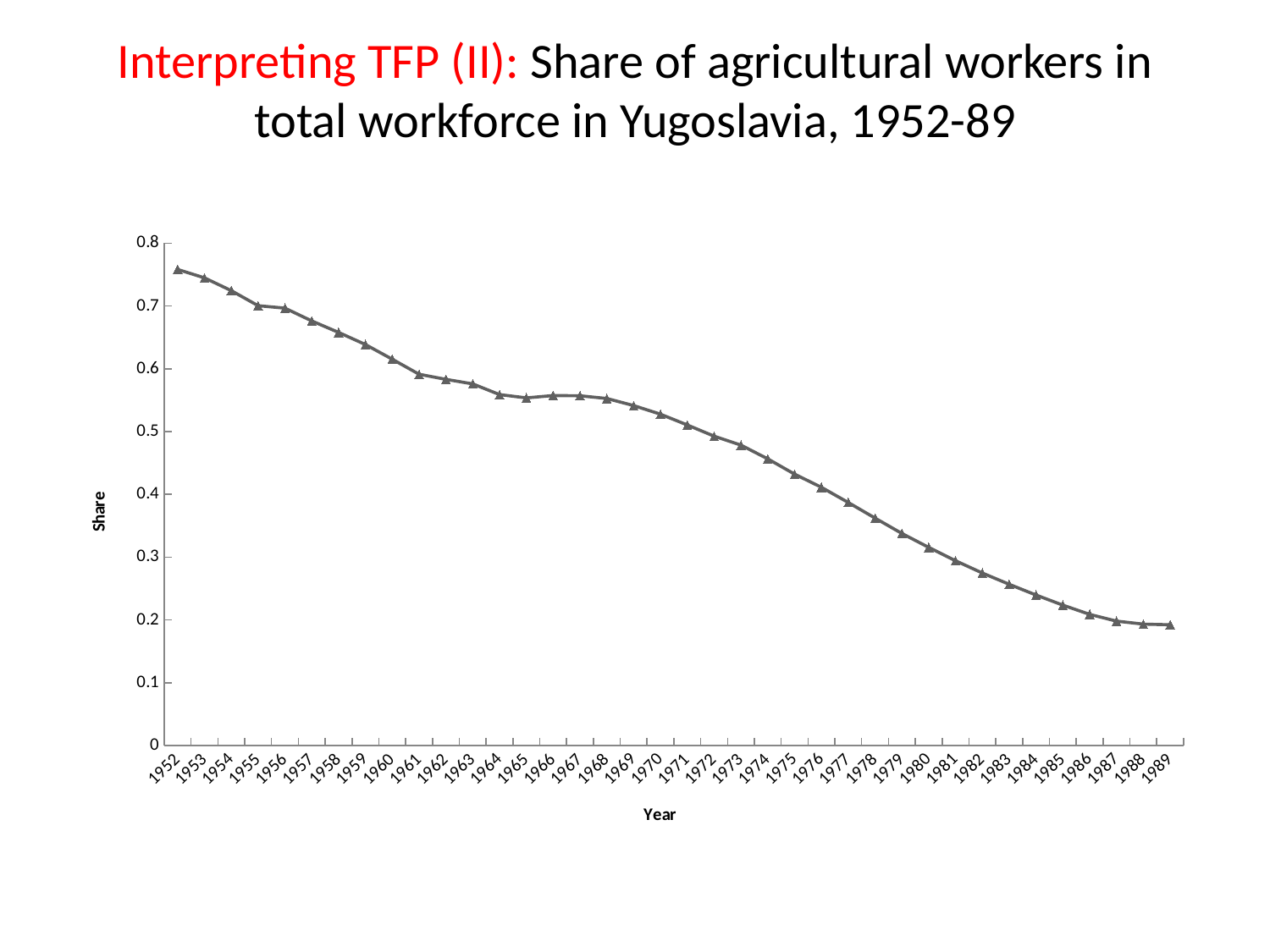
How many years are plotted on the x axis? 38 Is the value for 1952 greater or less than 0.7? greater Which year has the lowest share of agricultural workers? 1989 Is the value for 1965 greater or less than 0.5? greater What kind of chart is shown on the slide? Line chart Does the share of agricultural workers rise or fall from 1952 to 1989? Fall Is the value for 1985 greater or less than 0.3? less Which year has a larger share, 1960 or 1970? 1960 Which year has the highest share of agricultural workers? 1952 What is the label on the vertical axis? Share